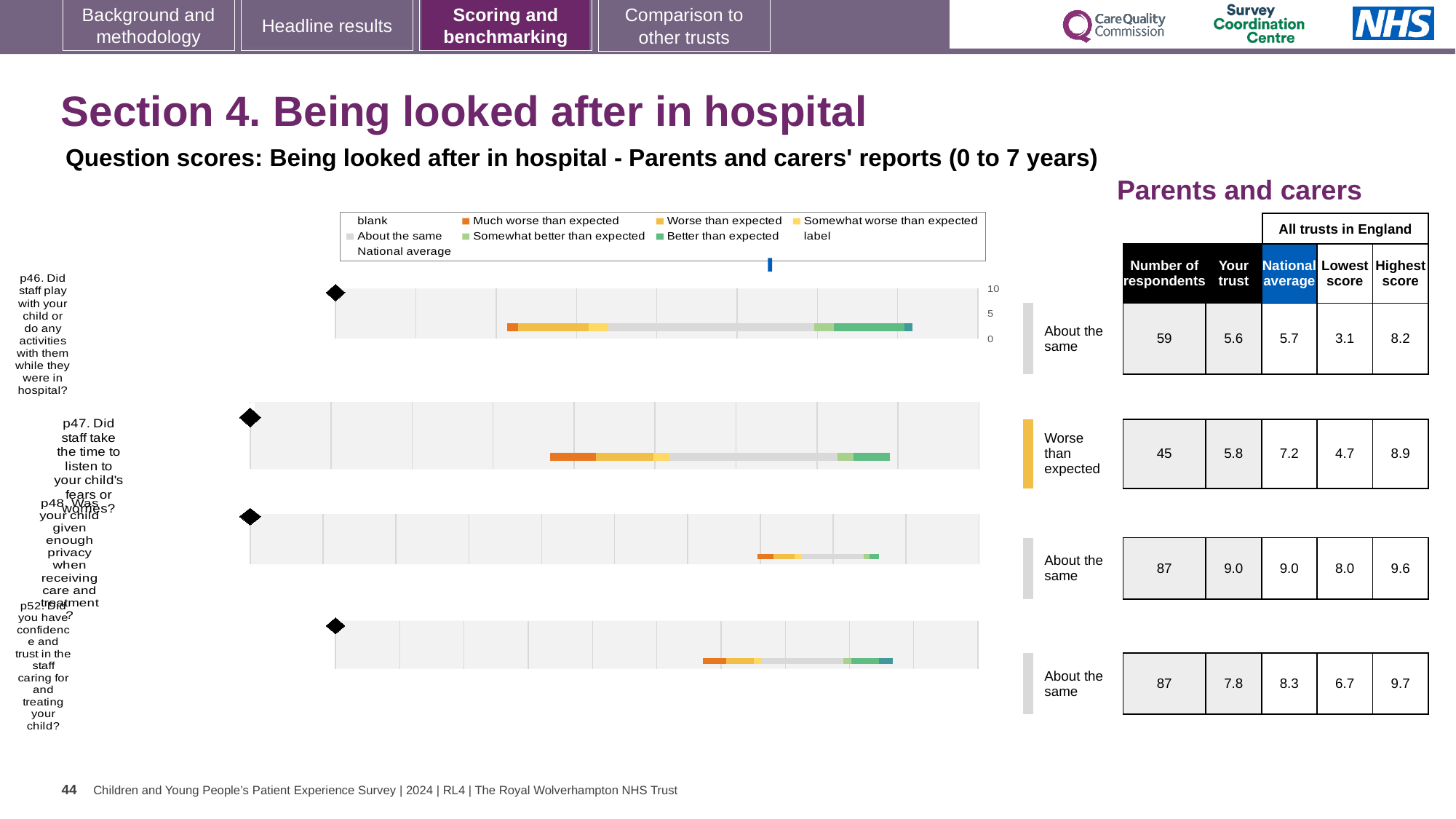
Which question has the lowest number of respondents in the table beside the chart? p47 In the table beside the chart, what is the national average for p47 (Did staff take the time to listen to your child's fears or worries?)? 7.2 How many survey questions are plotted as bars in the chart? 4 What is the difference between the national average and the 'Your trust' score for p47? 1.4 In the chart legend, what colour represents 'Much worse than expected'? orange What is the title printed above the chart? Question scores: Being looked after in hospital - Parents and carers' reports (0 to 7 years) In the table beside the chart, how many respondents answered p52 (Did you have confidence and trust in the staff caring for and treating your child?)? 87 Which benchmark label is shown next to the bar for p47? Worse than expected Which question has the highest 'Your trust' score in the table beside the chart? p48 In the table beside the chart, what is the 'Your trust' score for p46 (Did staff play with your child or do any activities with them while they were in hospital?)? 5.6 What kind of chart is used to show the question scores on this slide? bar chart In the table beside the chart, what is the highest score across all trusts in England for p48 (Was your child given enough privacy when receiving care and treatment?)? 9.6